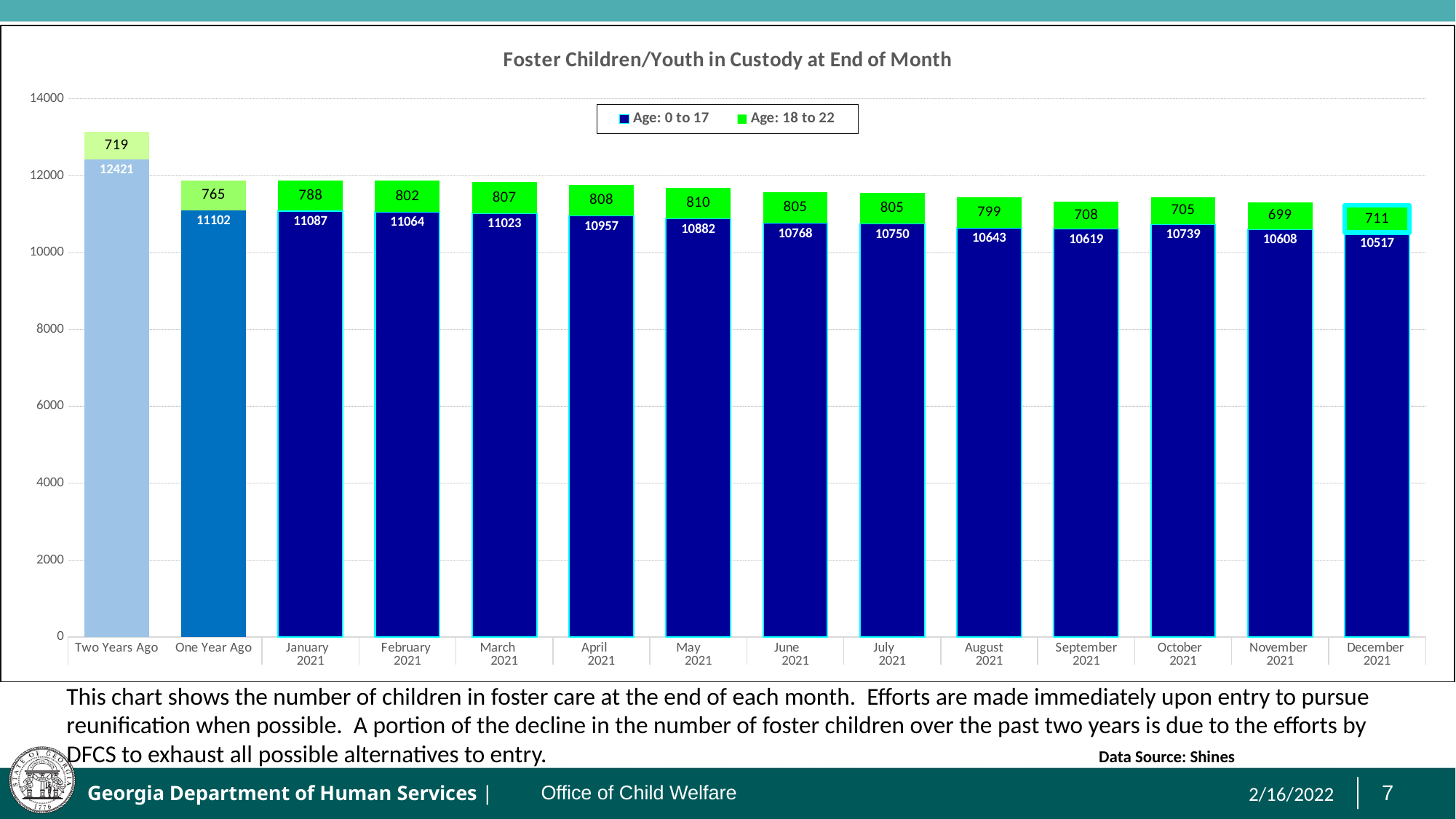
What is the value for Age: 18 to 22 in May 2021? 810 Which category has the highest value for Age: 0 to 17? Two Years Ago How many series does the legend list? 2 Which category has the lowest value for Age: 18 to 22? November 2021 What is the value for Age: 0 to 17 for Two Years Ago? 12421 How many categories are shown on the x axis? 14 What kind of chart is shown? Stacked bar chart What is the difference between the Age: 0 to 17 values for Two Years Ago and December 2021? 1904 Which category has the lowest value for Age: 0 to 17? December 2021 What is the value for Age: 0 to 17 in December 2021? 10517 What is the total of the stacked bar for December 2021? 11228 Which is larger, the Age: 0 to 17 value for October 2021 or for September 2021? October 2021